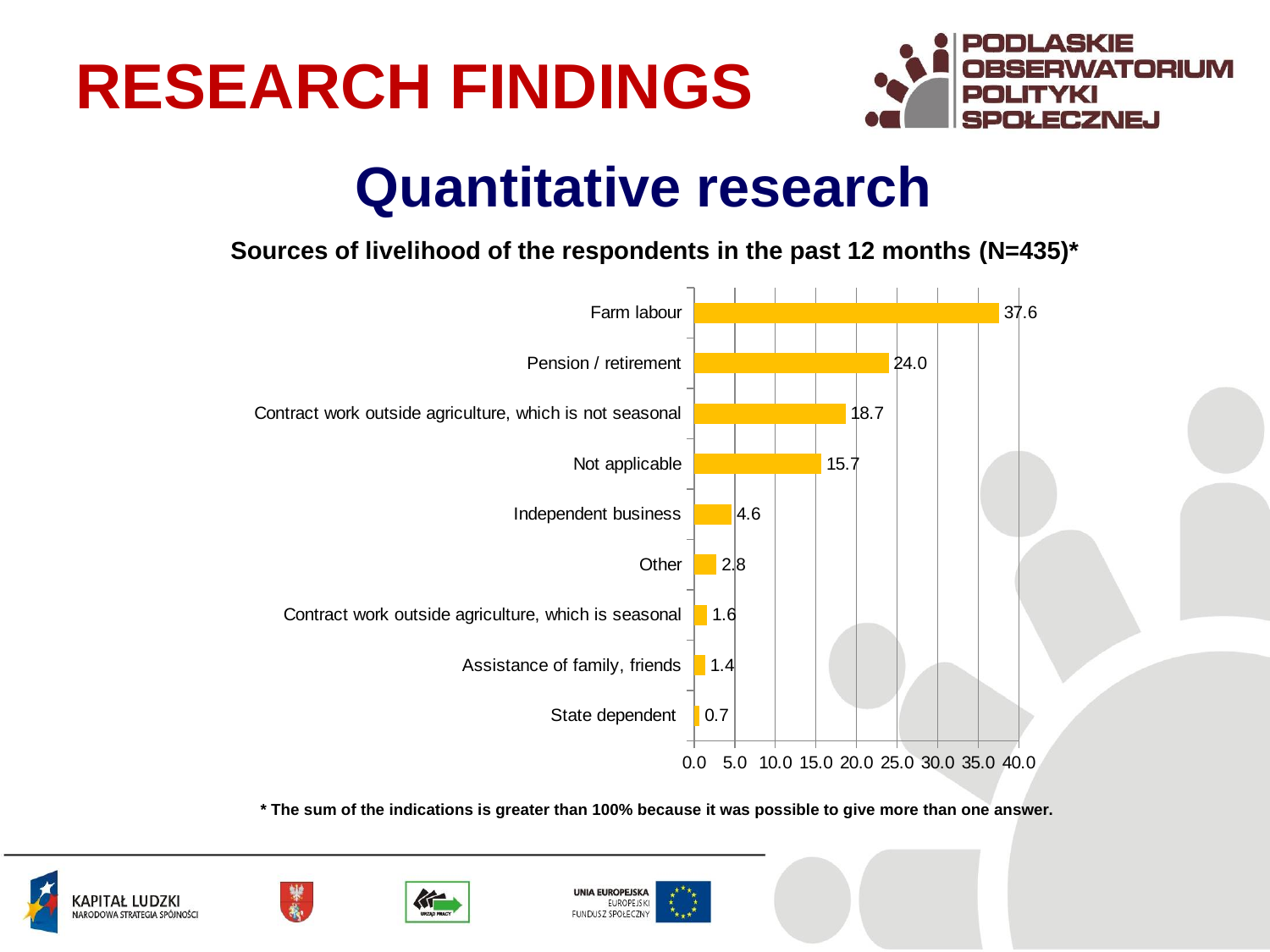
What is the difference between the values for Farm labour and Pension / retirement? 13.6 Which is larger: the value for Not applicable or the value for Contract work outside agriculture, which is not seasonal? Contract work outside agriculture, which is not seasonal What is the value for State dependent? 0.7 What is the value for Pension / retirement? 24.0 What is the value for Farm labour? 37.6 What kind of chart is shown on the slide? Bar chart What is the value for Independent business? 4.6 Is the value for Pension / retirement greater or less than 20.0? greater What is the title of the chart? Sources of livelihood of the respondents in the past 12 months (N=435)* Which category has the highest value? Farm labour How many categories are shown in the chart? 9 Which category has the lowest value? State dependent